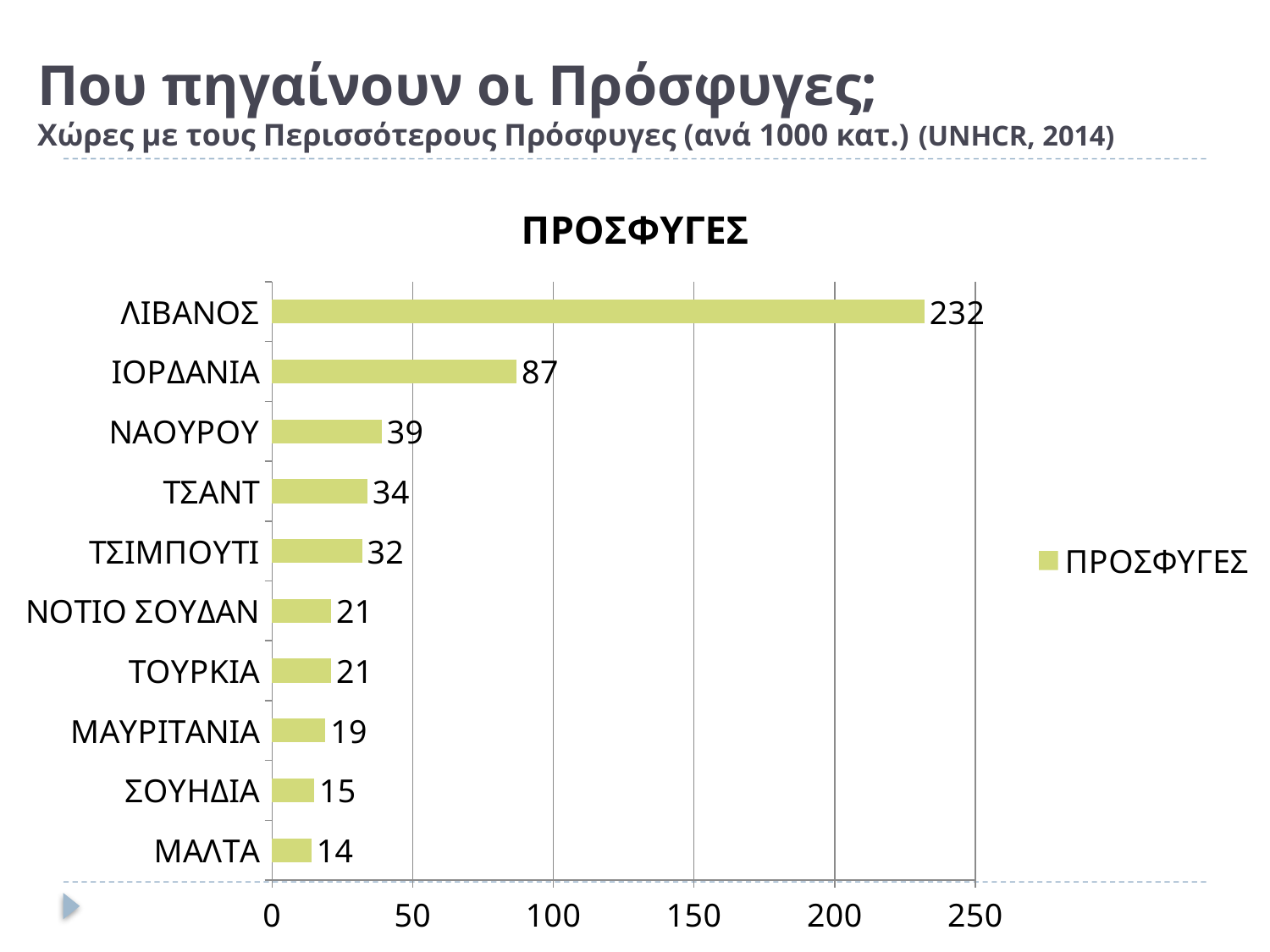
What is the difference between the values for ΛΙΒΑΝΟΣ and ΙΟΡΔΑΝΙΑ? 145 What is the difference between the values for ΝΑΟΥΡΟΥ and ΤΣΑΝΤ? 5 What is the value for ΤΣΙΜΠΟΥΤΙ? 32 Is the value for ΙΟΡΔΑΝΙΑ greater or less than 100? less Which has a larger value, ΜΑΥΡΙΤΑΝΙΑ or ΣΟΥΗΔΙΑ? ΜΑΥΡΙΤΑΝΙΑ Which country has the lowest value? ΜΑΛΤΑ What is the value for ΛΙΒΑΝΟΣ? 232 What is the title of the chart? ΠΡΟΣΦΥΓΕΣ Which country has the highest value? ΛΙΒΑΝΟΣ What kind of chart is shown on the slide? bar chart How many countries are shown in the chart? 10 What is the value for ΙΟΡΔΑΝΙΑ? 87